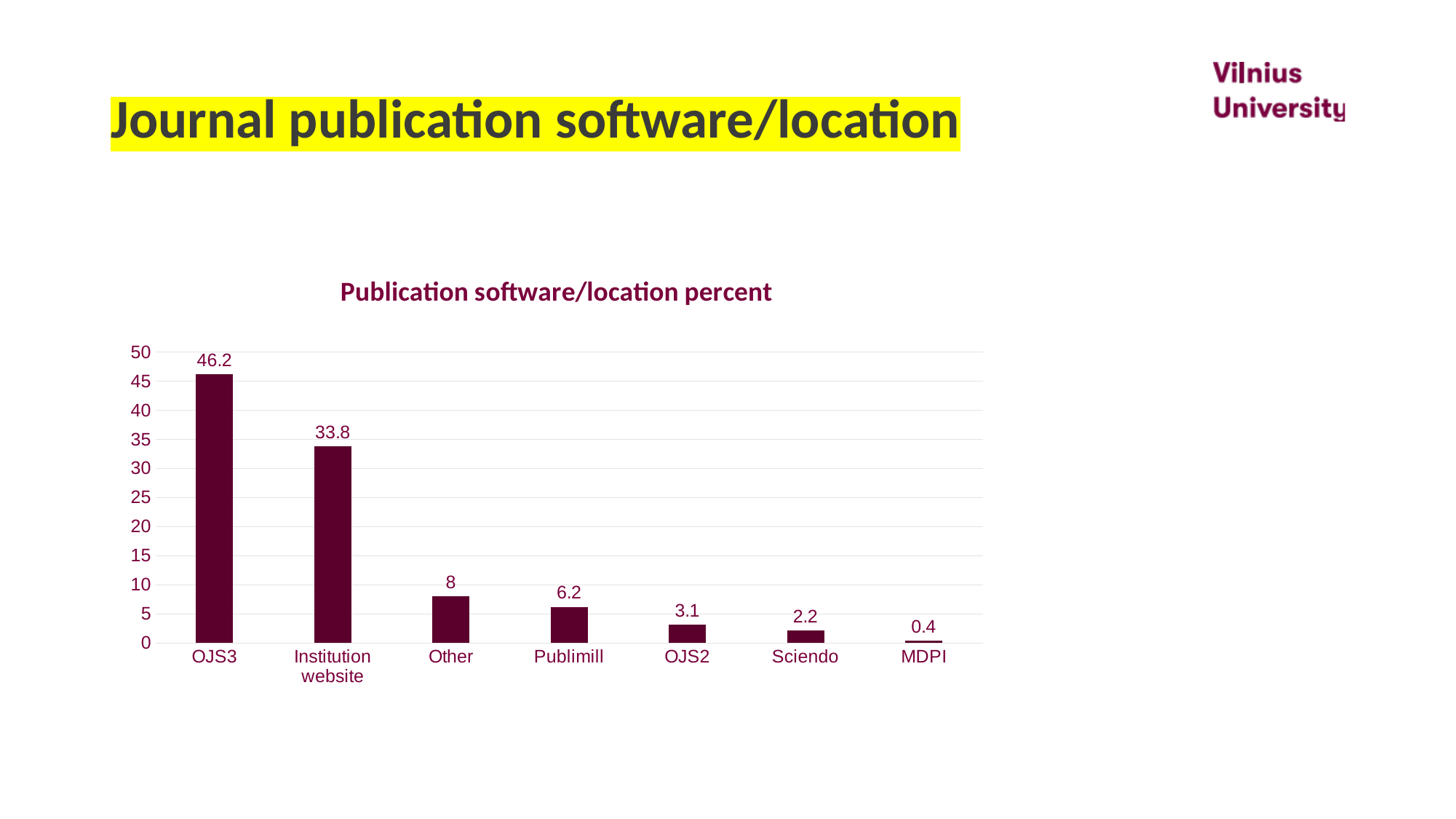
Is the value for OJS2 greater or less than 5? less How many categories are shown on the x axis? 7 What is the title of the chart? Publication software/location percent What is the difference between the values for OJS3 and Institution website? 12.4 Which is larger, the value for Other or the value for Publimill? Other What kind of chart is shown on the slide? bar chart What is the value for Publimill? 6.2 What is the value for MDPI? 0.4 What is the value for Institution website? 33.8 Which category has the highest value? OJS3 Which category has the lowest value? MDPI What is the value for OJS3? 46.2